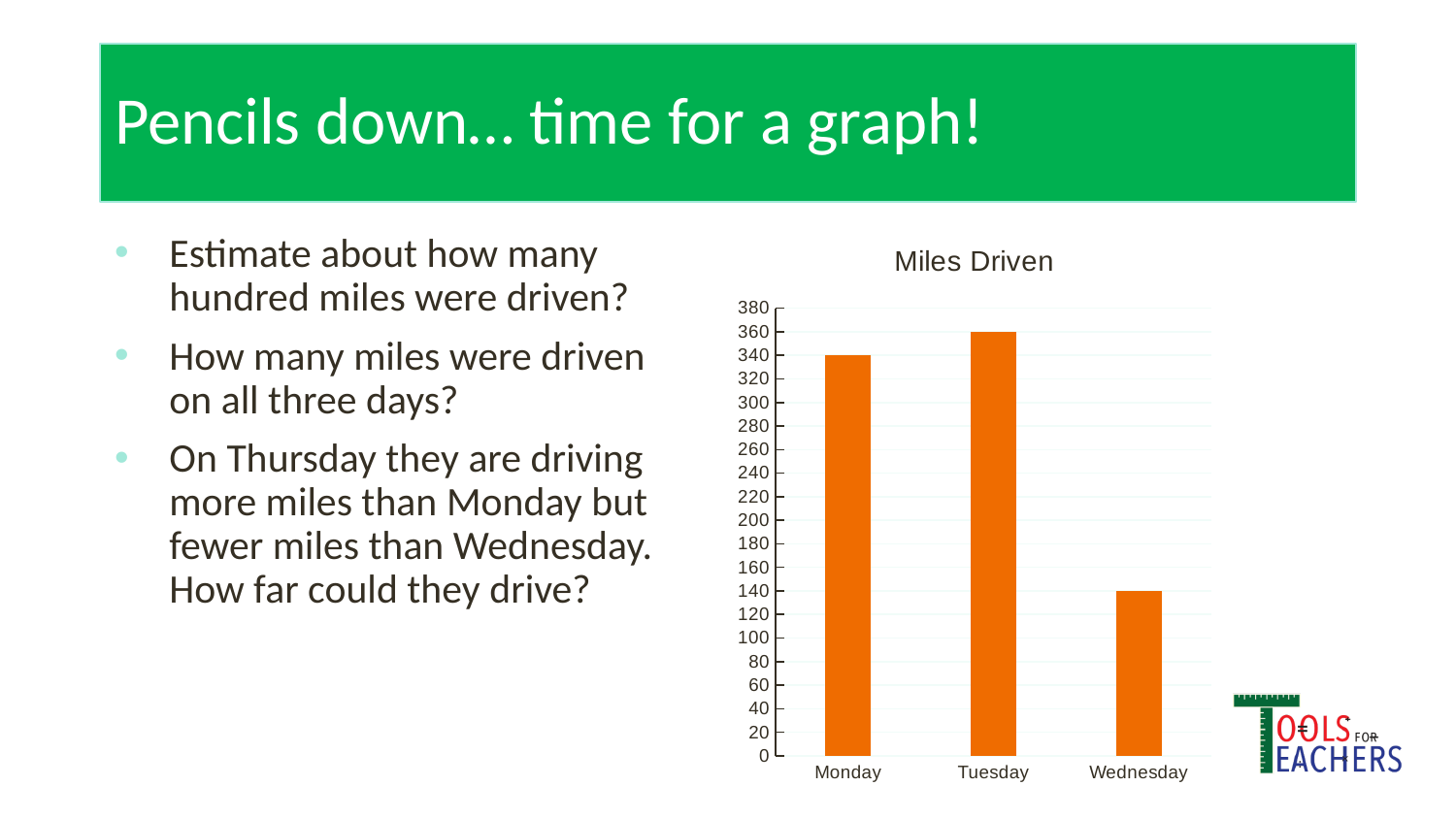
How many more miles were driven on Monday than on Wednesday? 200 How many miles were driven on Tuesday? 360 How many miles were driven on Monday? 340 What is the title of the chart? Miles Driven On which day were the fewest miles driven? Wednesday Do the values rise or fall from Tuesday to Wednesday? fall Which day has the larger value, Monday or Wednesday? Monday On which day were the most miles driven? Tuesday Is the value for Wednesday greater or less than 200? less How many days are shown on the x axis of the chart? 3 How many miles were driven on Wednesday? 140 What kind of chart is shown on the slide? bar chart